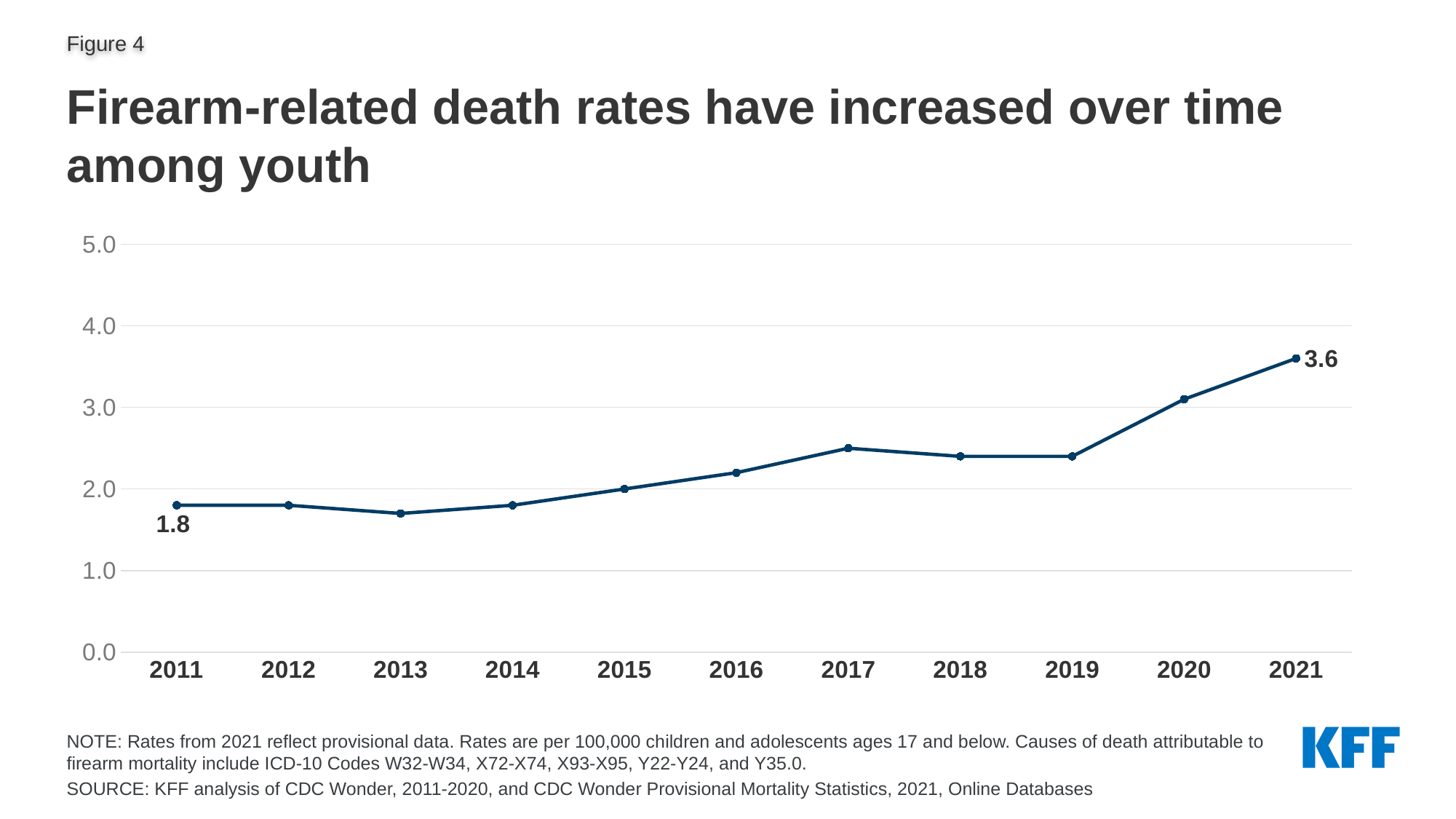
What is the difference between the 2021 and 2011 death rates? 1.8 Is the value for 2020 greater or less than 3.0? greater Is the value for 2017 greater or less than 3.0? less Do the death rates generally rise or fall from 2011 to 2021? rise Which year has the highest firearm-related death rate? 2021 Which year has a higher death rate, 2020 or 2017? 2020 How many years are plotted on the chart? 11 What is the firearm-related death rate for 2021? 3.6 What kind of chart is shown on the slide? line chart What is the firearm-related death rate for 2011? 1.8 Is the value for 2013 greater or less than 2.0? less Which year has the lowest firearm-related death rate? 2013